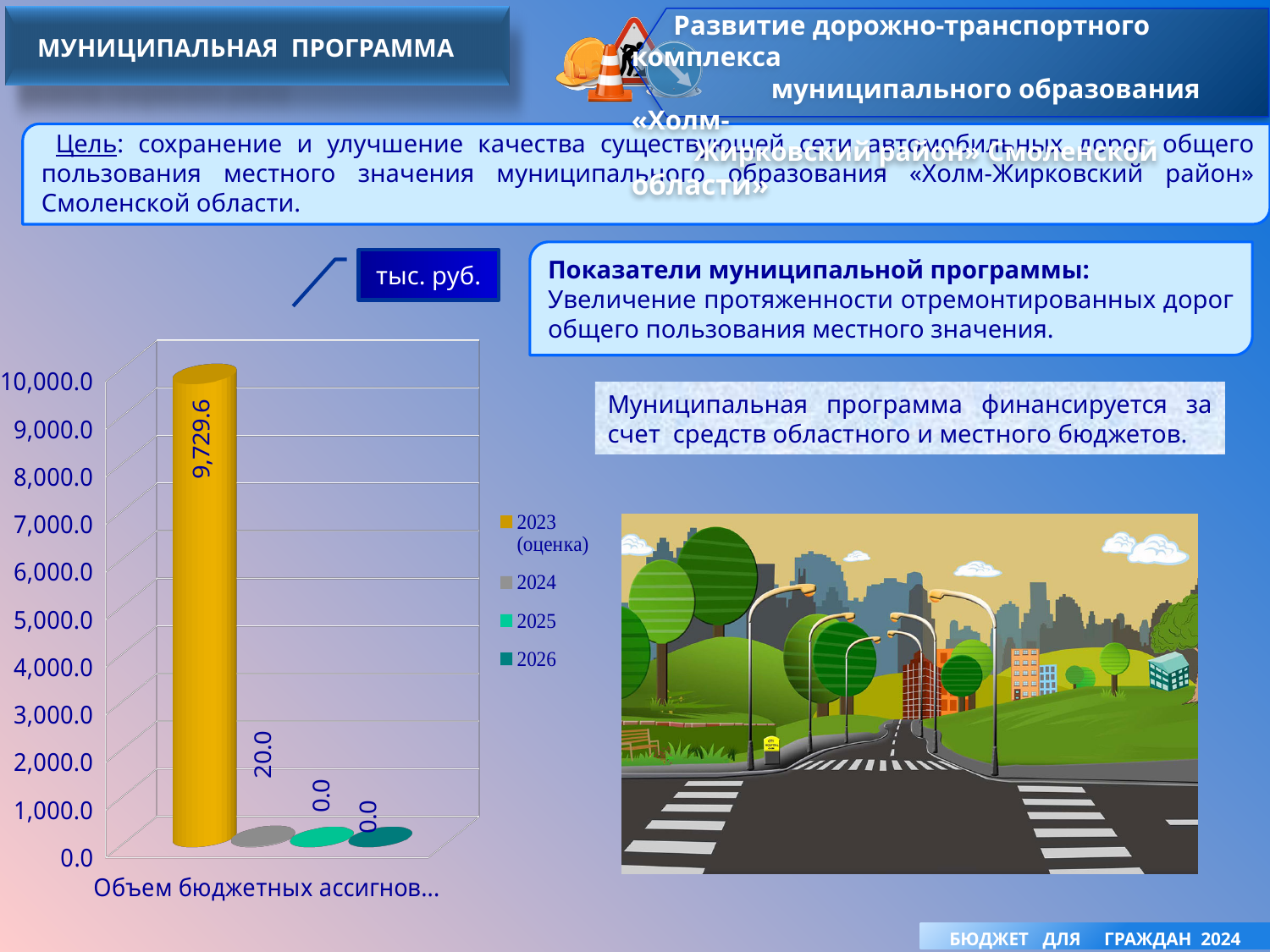
What is the value for 2024 in the chart? 20.0 What is the difference between the values for 2023 (оценка) and 2024? 9,709.6 How many series does the chart legend list? 4 Is the value for 2023 (оценка) greater or less than 9,000.0? greater What is the value for 2023 (оценка) in the chart? 9,729.6 What is the value for 2025 in the chart? 0.0 What colour is the bar for 2023 (оценка) in the chart? yellow What kind of chart is shown on the slide? bar chart Which is larger, the value for 2024 or the value for 2025? 2024 What unit of measurement is indicated for the chart values? тыс. руб. Which series has the highest value in the chart? 2023 (оценка) What is the value for 2026 in the chart? 0.0